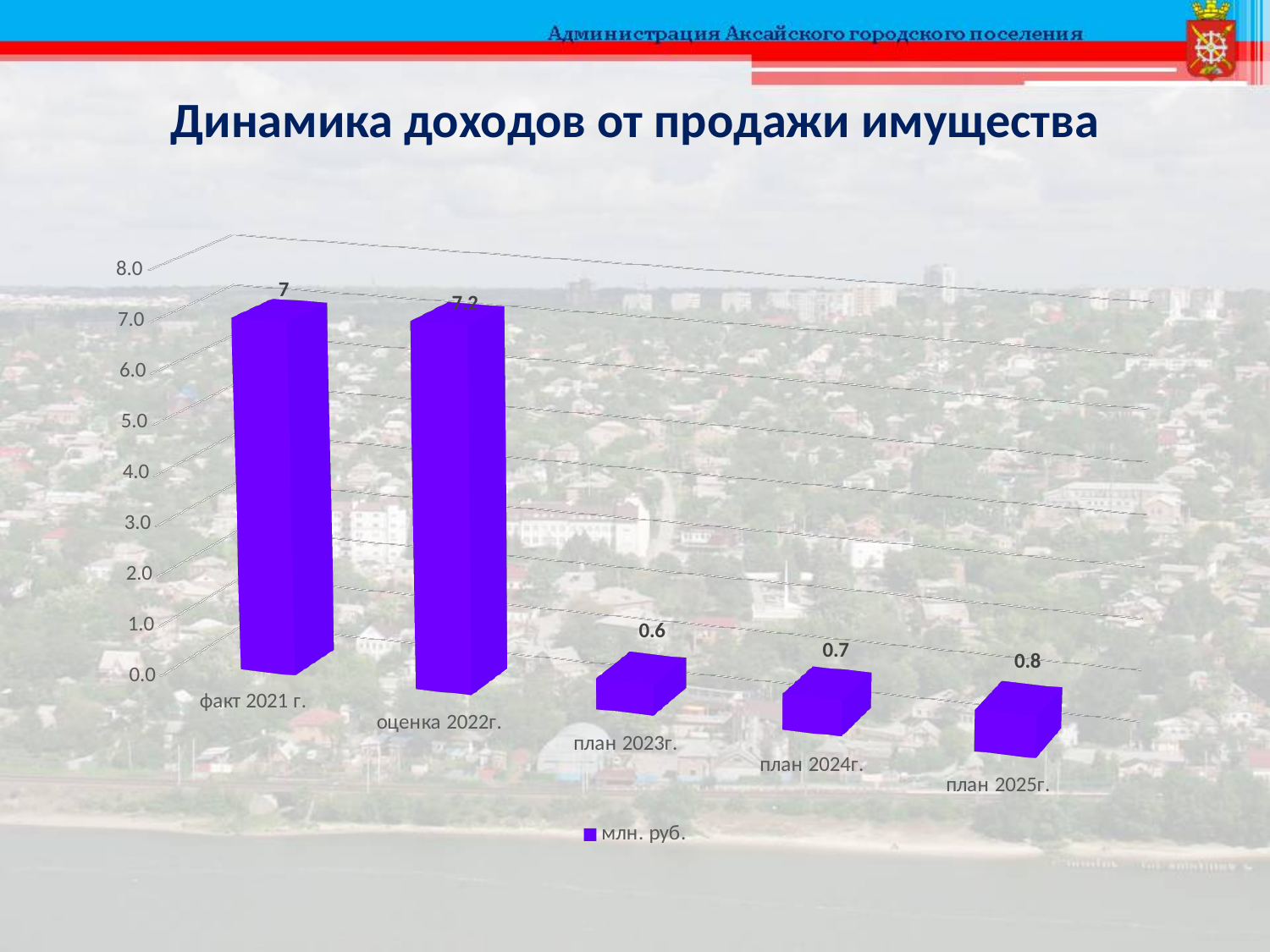
What is the value for план 2025г.? 0.8 Which category has the highest value? оценка 2022г. What is the value for оценка 2022г.? 7.2 What is the value for план 2023г.? 0.6 How many categories are shown on the x axis? 5 What is the title of the chart? Динамика доходов от продажи имущества What kind of chart is shown on the slide? bar chart Is the value for факт 2021 г. greater or less than 5.0? greater What is the value for факт 2021 г.? 7 Which is larger, the value for план 2024г. or the value for план 2025г.? план 2025г. What is the difference between the values for оценка 2022г. and план 2023г.? 6.6 Which category has the lowest value? план 2023г.